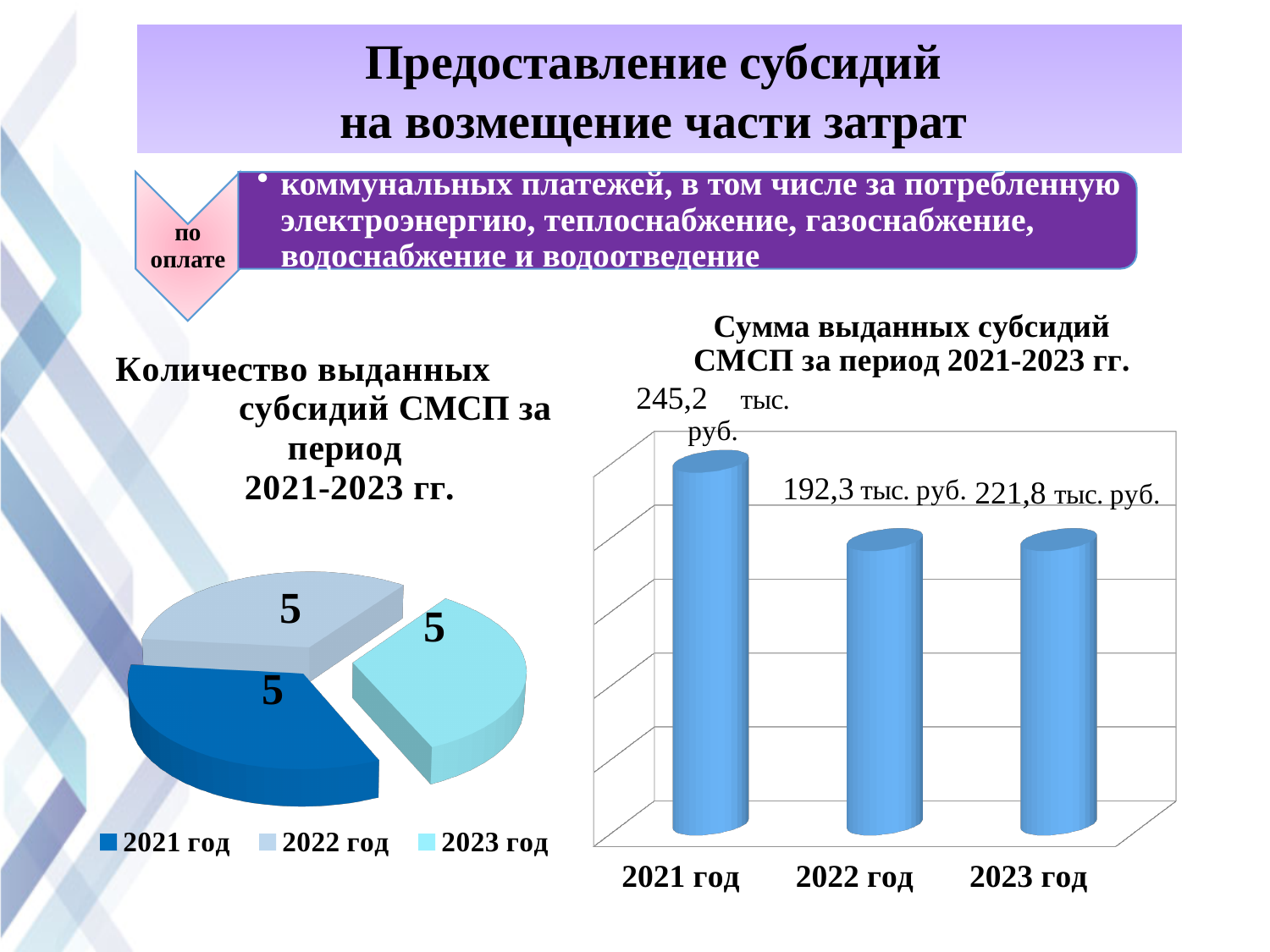
On the bar chart 'Сумма выданных субсидий СМСП за период 2021-2023 гг.', what is the value for 2023 год? 221,8 тыс. руб. On the bar chart 'Сумма выданных субсидий СМСП за период 2021-2023 гг.', which year has the highest value? 2021 год What kind of chart is the chart on the left, 'Количество выданных субсидий СМСП за период 2021-2023 гг.'? Pie chart How many bars are on the bar chart 'Сумма выданных субсидий СМСП за период 2021-2023 гг.'? 3 How many entries does the legend of the pie chart 'Количество выданных субсидий СМСП за период 2021-2023 гг.' list? 3 On the pie chart 'Количество выданных субсидий СМСП за период 2021-2023 гг.', what is the value for 2022 год? 5 On the bar chart 'Сумма выданных субсидий СМСП за период 2021-2023 гг.', what is the value for 2022 год? 192,3 тыс. руб. On the bar chart 'Сумма выданных субсидий СМСП за период 2021-2023 гг.', what is the difference between the values for 2021 год and 2022 год? 52,9 тыс. руб. On the bar chart 'Сумма выданных субсидий СМСП за период 2021-2023 гг.', what is the value for 2021 год? 245,2 тыс. руб.